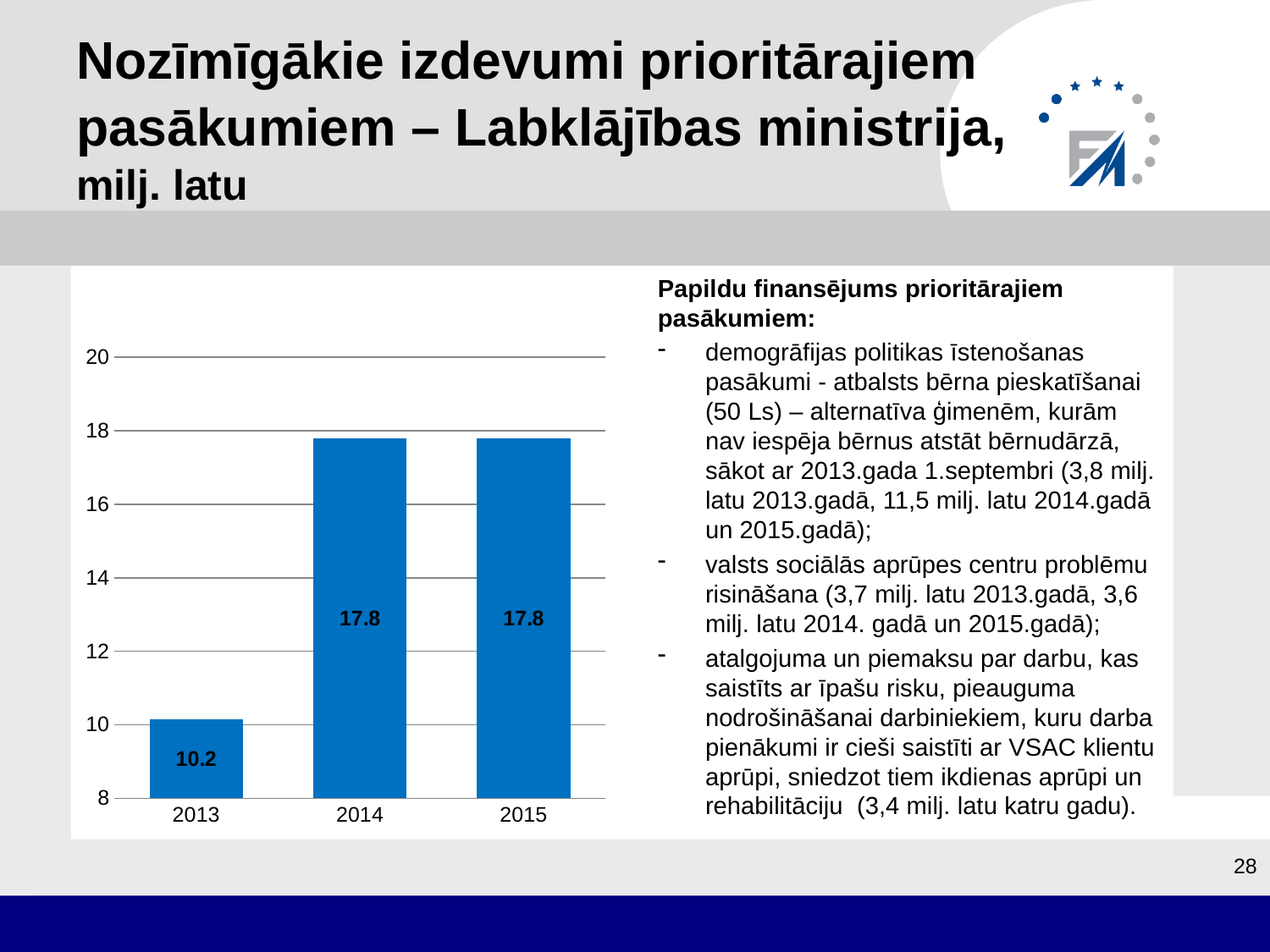
How many years are shown on the x axis? 3 What kind of chart is shown on the slide? bar chart Do the values rise or fall from 2013 to 2014? rise What is the value for 2014? 17.8 What is the difference between the values for 2014 and 2013? 7.6 Is the value for 2013 greater or less than 12? less What is the value for 2013? 10.2 Is the value for 2014 greater or less than 16? greater What unit is stated in the slide title for the chart values? milj. latu What is the value for 2015? 17.8 Which year has the lowest value? 2013 Which is larger, the value for 2013 or the value for 2015? 2015